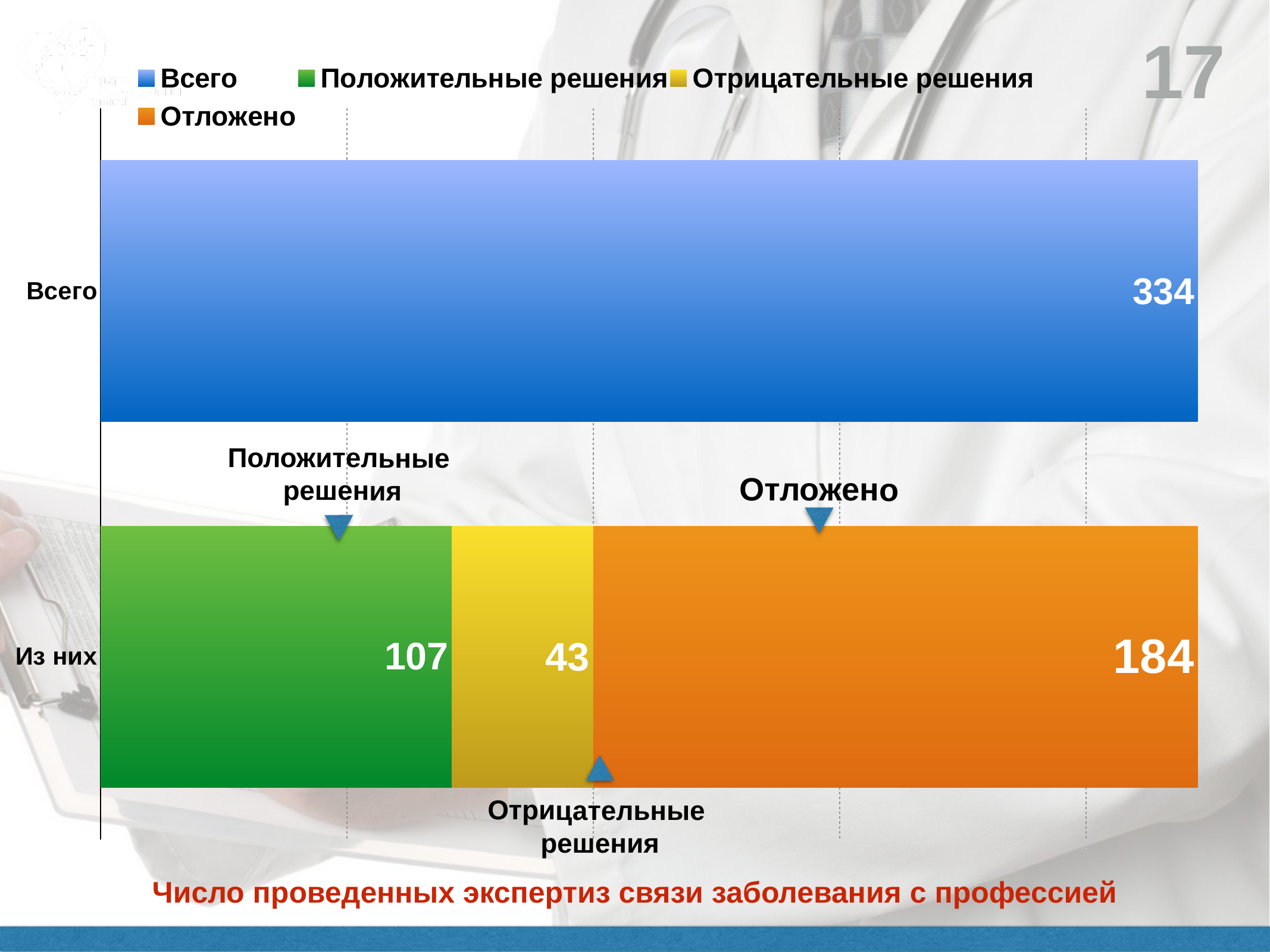
What kind of chart is shown on the slide? Bar chart Which is larger: "Положительные решения" or "Отрицательные решения"? Положительные решения What is the title of the chart? Число проведенных экспертиз связи заболевания с профессией In the "Из них" bar, what is the value for "Отложено"? 184 In the "Из них" bar, what is the value for "Положительные решения"? 107 How many series does the legend list? 4 Which segment of the "Из них" bar is the smallest? Отрицательные решения Which segment of the "Из них" bar is the largest? Отложено What is the difference between the "Отложено" value and the "Положительные решения" value? 77 What is the total of the "Из них" stacked bar? 334 What is the value of the "Всего" bar? 334 In the "Из них" bar, what is the value for "Отрицательные решения"? 43